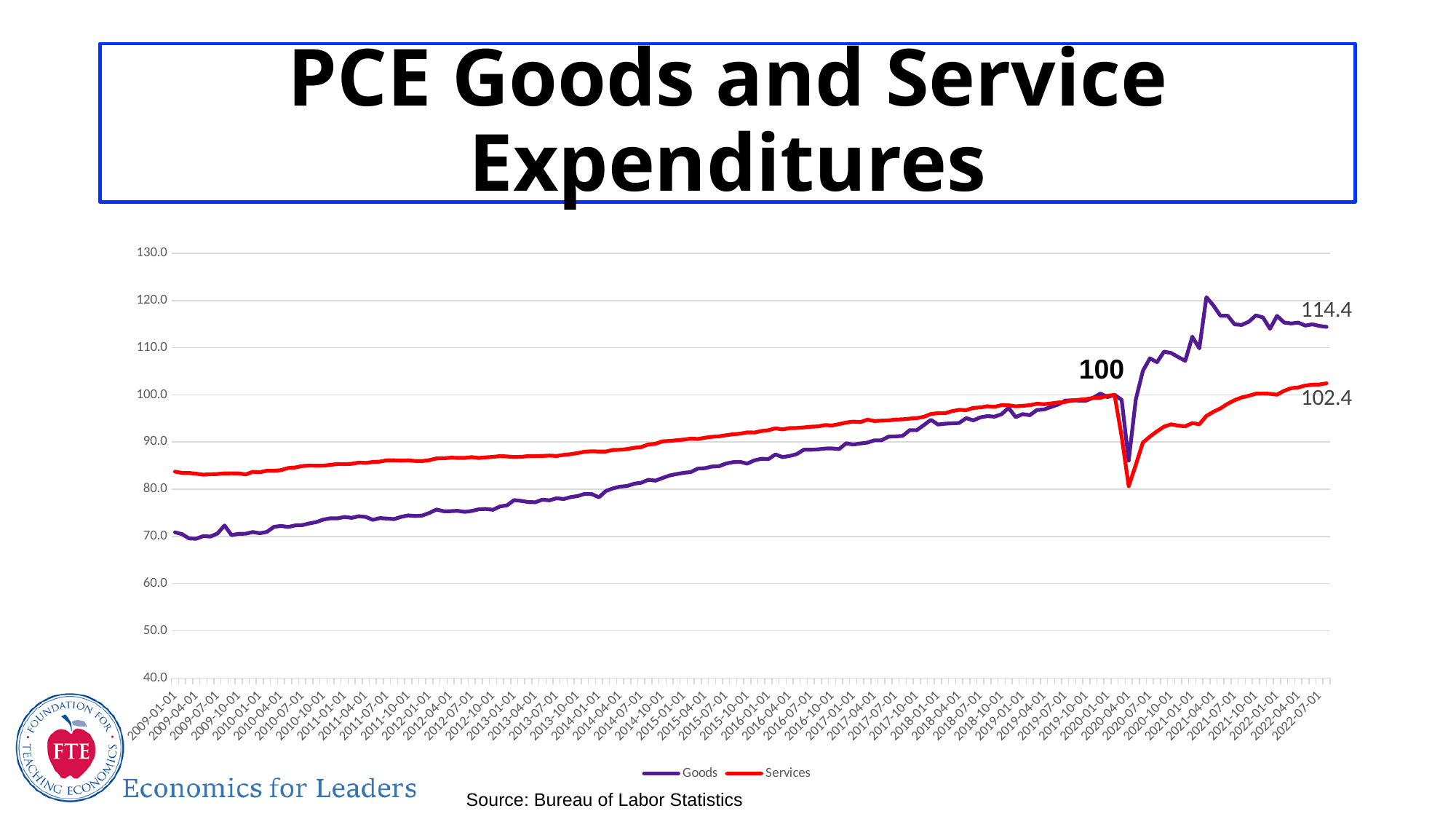
Is the value for Goods at 2009-01-01 greater or less than 80? less What colour is the Services line? red Is the lowest value of the Services series during 2020 greater or less than 90? less How many series does the legend list? 2 At the start of the series in 2009, which is higher, Goods or Services? Services Does the Goods series generally rise or fall from 2009 to 2022? rise What kind of chart is shown on the slide? line chart At the end of the series, which is higher, Goods or Services? Goods What is the last labelled value of the Goods series? 114.4 What is the difference between the final labelled Goods value and the final labelled Services value? 12.0 What value is labelled on the chart at the point where the two lines meet around 2020-01-01? 100 What is the last labelled value of the Services series? 102.4